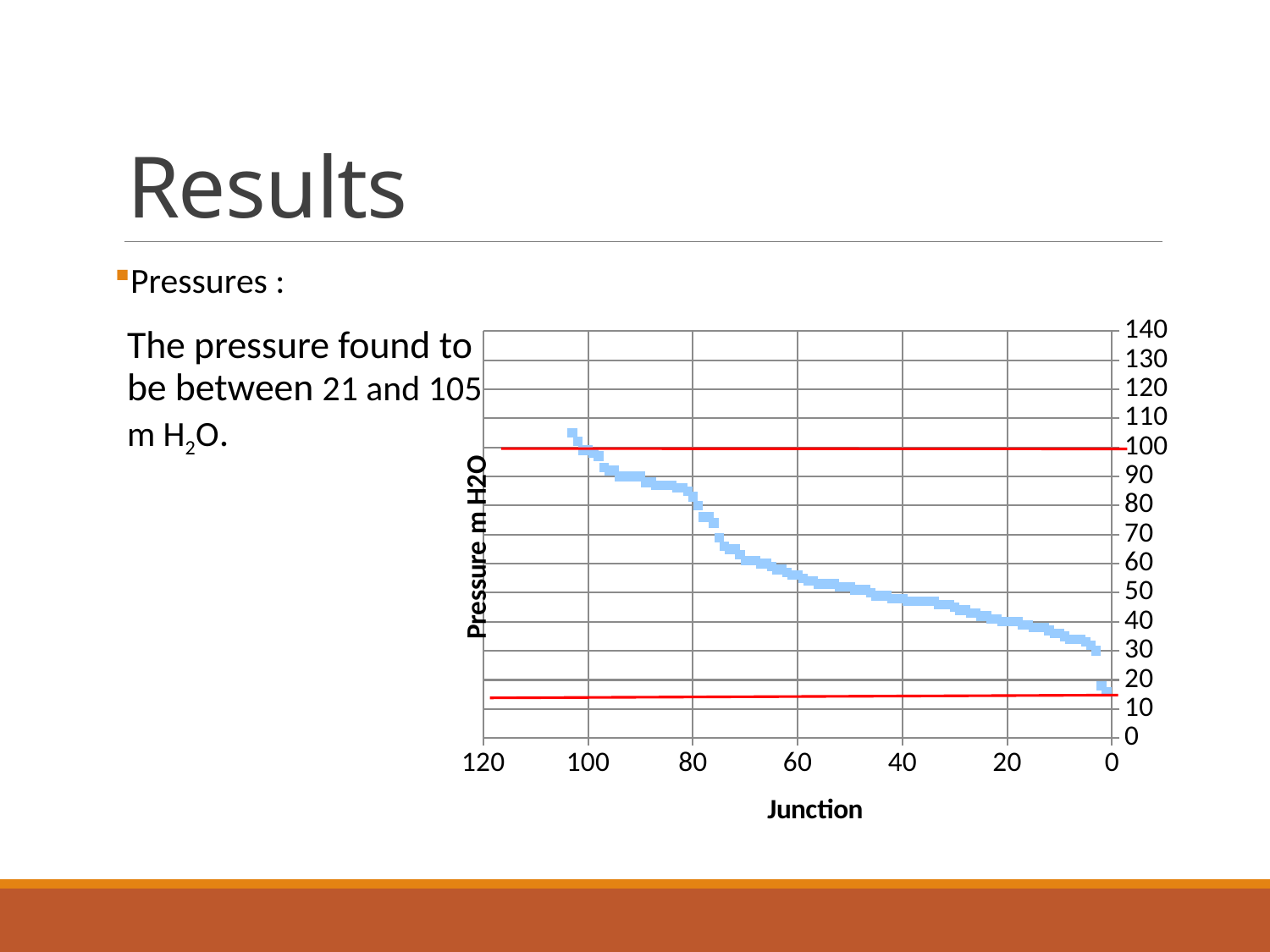
What is the label of the horizontal axis of the chart? Junction Is the pressure plotted at junction 60 greater or less than the pressure plotted at junction 20? greater What is the label of the vertical axis of the chart? Pressure m H2O Do the plotted pressure values rise or fall as the junction number increases along the x axis? rise Is the lowest plotted pressure value greater or less than 20? less What kind of chart is shown on the slide? scatter chart Is the highest plotted pressure value greater or less than 100? greater Is the pressure plotted at junction 60 greater or less than 60? less